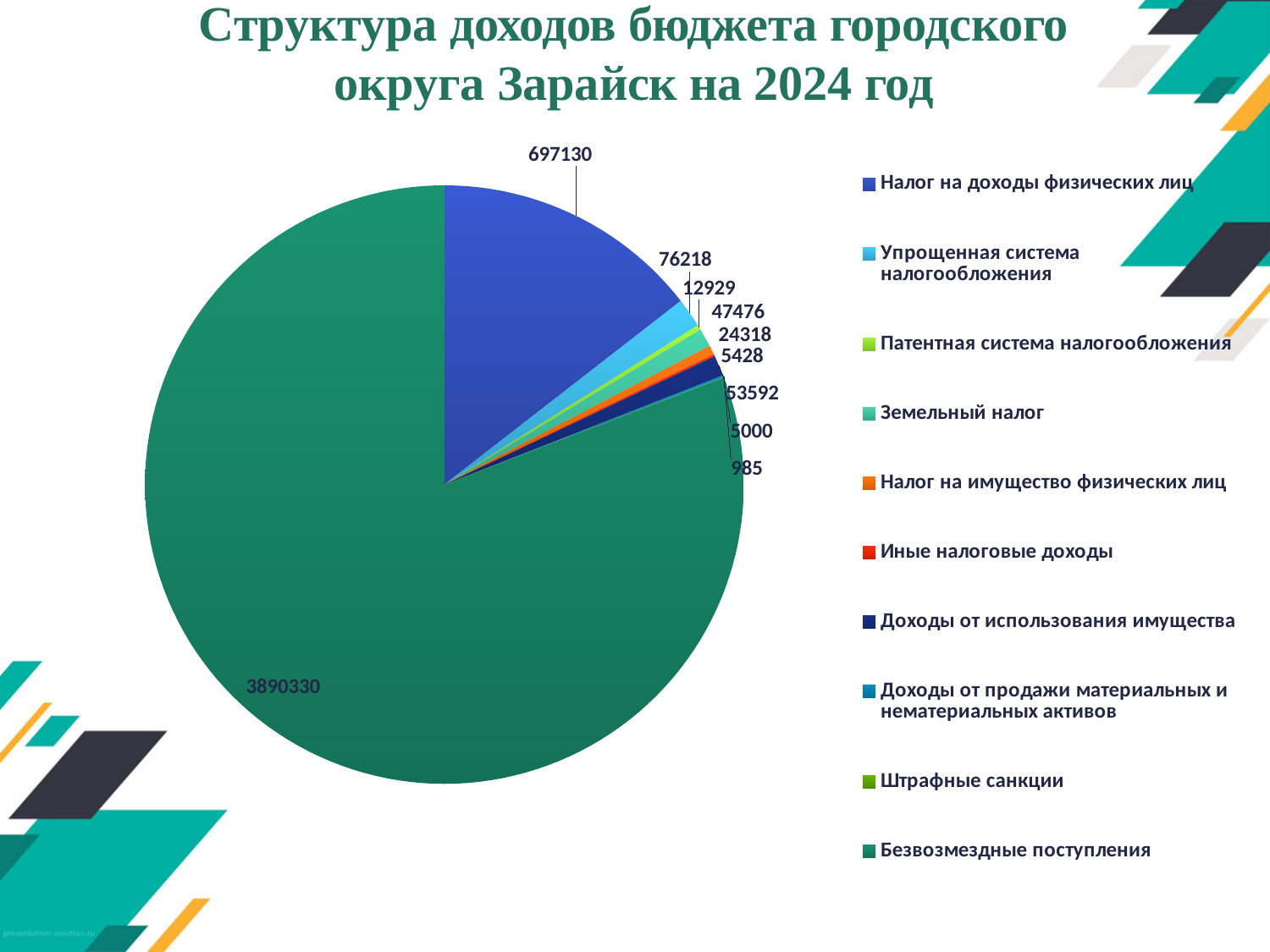
Which category has the smallest slice of the pie? Штрафные санкции What is the value for Безвозмездные поступления? 3890330 What is the value for Налог на доходы физических лиц? 697130 Which is larger: Налог на доходы физических лиц or Упрощенная система налогообложения? Налог на доходы физических лиц What is the title of the chart on the slide? Структура доходов бюджета городского округа Зарайск на 2024 год What is the value for Штрафные санкции? 985 What type of chart is shown on the slide? pie chart Which category has the largest slice of the pie? Безвозмездные поступления What is the difference between Безвозмездные поступления and Налог на доходы физических лиц? 3193200 What is the value for Земельный налог? 47476 How many categories does the legend of the pie chart list? 10 What is the value for Упрощенная система налогообложения? 76218